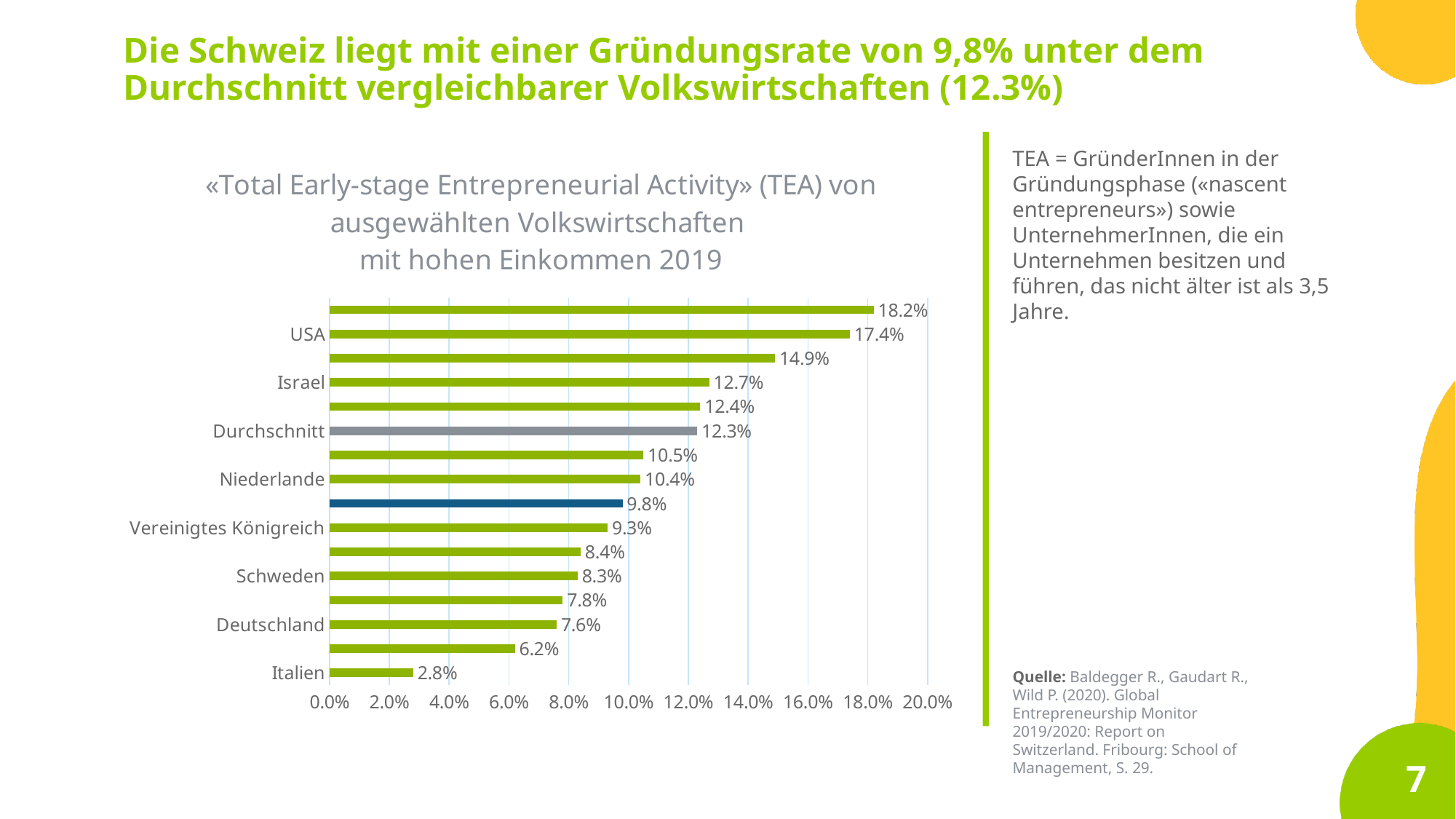
What is the TEA value for Israel? 12.7% Which labelled category has the lowest value? Italien Which has a higher value, Niederlande or Schweden? Niederlande What is the TEA value for the USA? 17.4% What is the highest value shown on the chart? 18.2% What is the difference between the values for the USA and Israel? 4.7% How many bars are plotted on the chart? 16 What value does the dark blue bar show? 9.8% Is the value for Schweden greater or less than 10.0%? less What value is shown for Durchschnitt? 12.3% What is the TEA value for Italien? 2.8% What is the TEA value for Deutschland? 7.6%